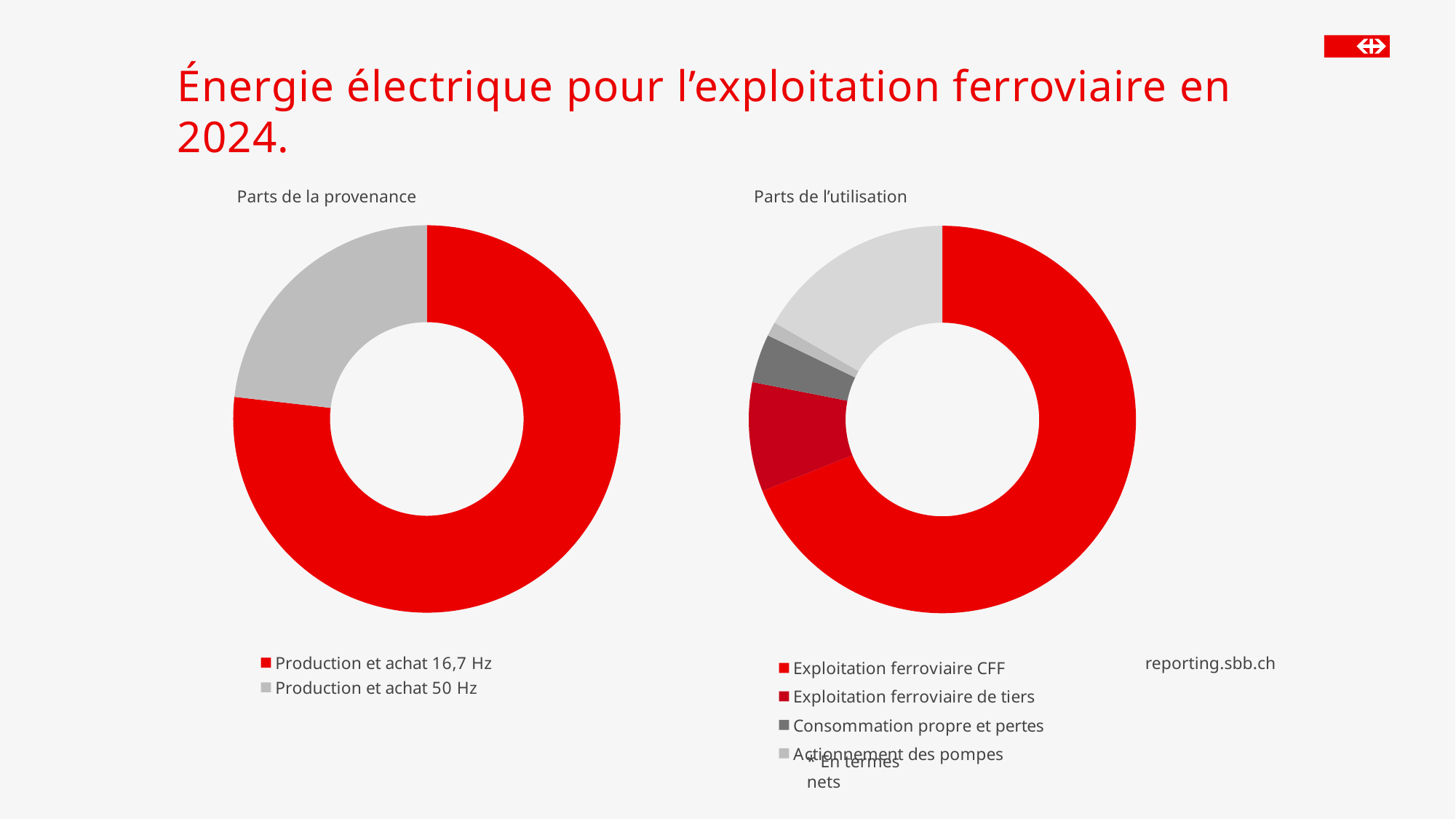
What kind of chart is the "Parts de l’utilisation" chart? Doughnut (pie) chart In the "Parts de la provenance" chart, which category has the largest share? Production et achat 16,7 Hz In the "Parts de l’utilisation" chart, which is larger: Actionnement des pompes or Consommation propre et pertes? Consommation propre et pertes What kind of chart is the "Parts de la provenance" chart? Doughnut (pie) chart In the "Parts de l’utilisation" chart, what colour is the Exploitation ferroviaire CFF slice? Red What is the title of the chart on the left of the slide? Parts de la provenance In the "Parts de l’utilisation" chart, which category has the largest share? Exploitation ferroviaire CFF In the "Parts de la provenance" chart, which category has the smallest share? Production et achat 50 Hz In the "Parts de la provenance" chart, which is larger: Production et achat 16,7 Hz or Production et achat 50 Hz? Production et achat 16,7 Hz In the "Parts de l’utilisation" chart, which is larger: Exploitation ferroviaire CFF or Exploitation ferroviaire de tiers? Exploitation ferroviaire CFF How many categories does the legend of the "Parts de la provenance" chart list? 2